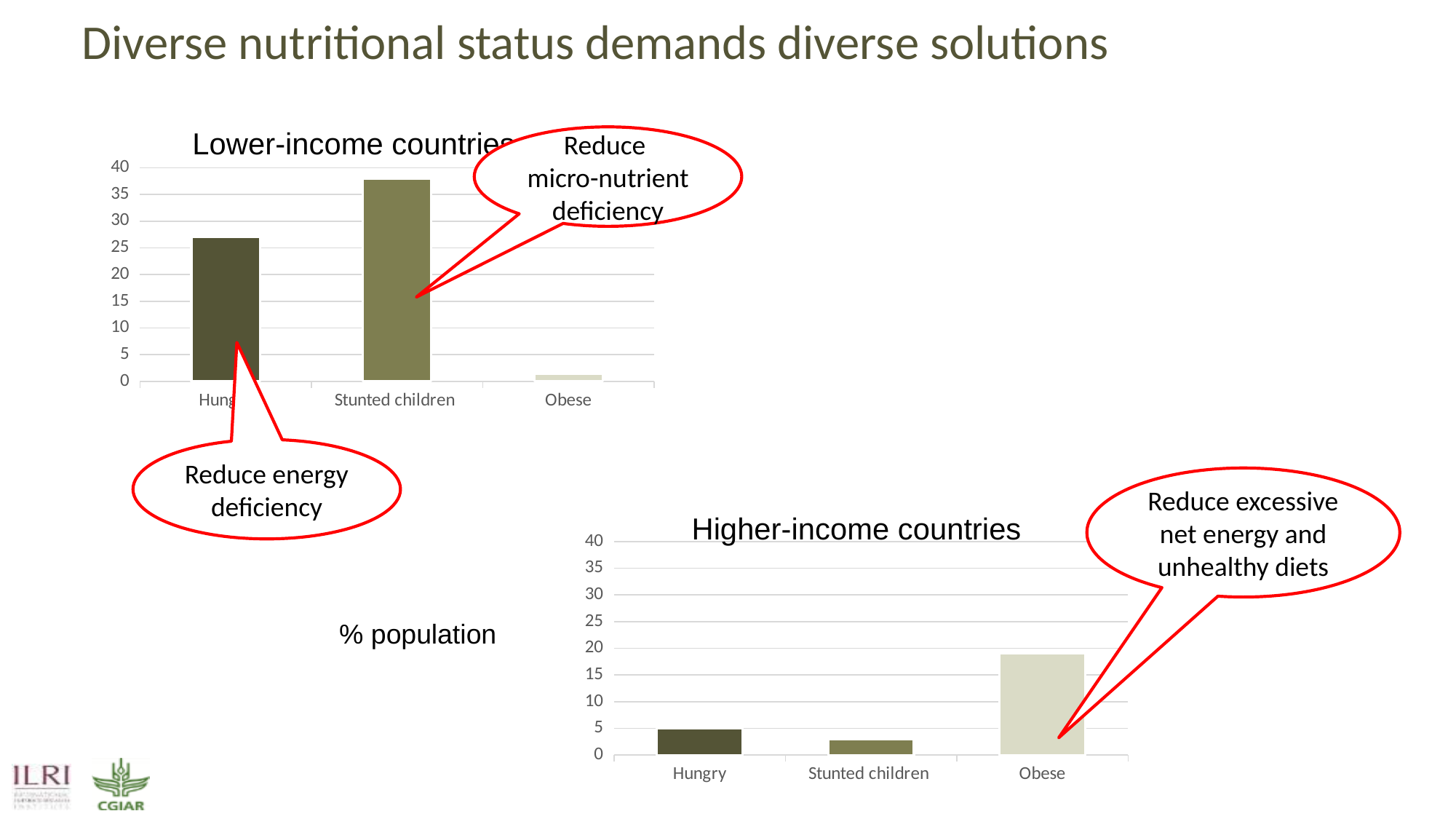
In the "Higher-income countries" chart, which category has the lowest value? Stunted children In the "Higher-income countries" chart, is the value for Obese greater or less than 15? greater How many categories are shown on the x axis of the "Higher-income countries" chart? 3 In the "Higher-income countries" chart, is the value for Hungry greater or less than 10? less In the "Lower-income countries" chart, which category has the highest value? Stunted children In the "Higher-income countries" chart, which is larger, the value for Hungry or the value for Obese? Obese In the "Lower-income countries" chart, which category has the lowest value? Obese What kind of chart is the "Lower-income countries" chart? Bar chart In the "Lower-income countries" chart, is the value for Obese greater or less than 5? less In the "Higher-income countries" chart, which category has the highest value? Obese